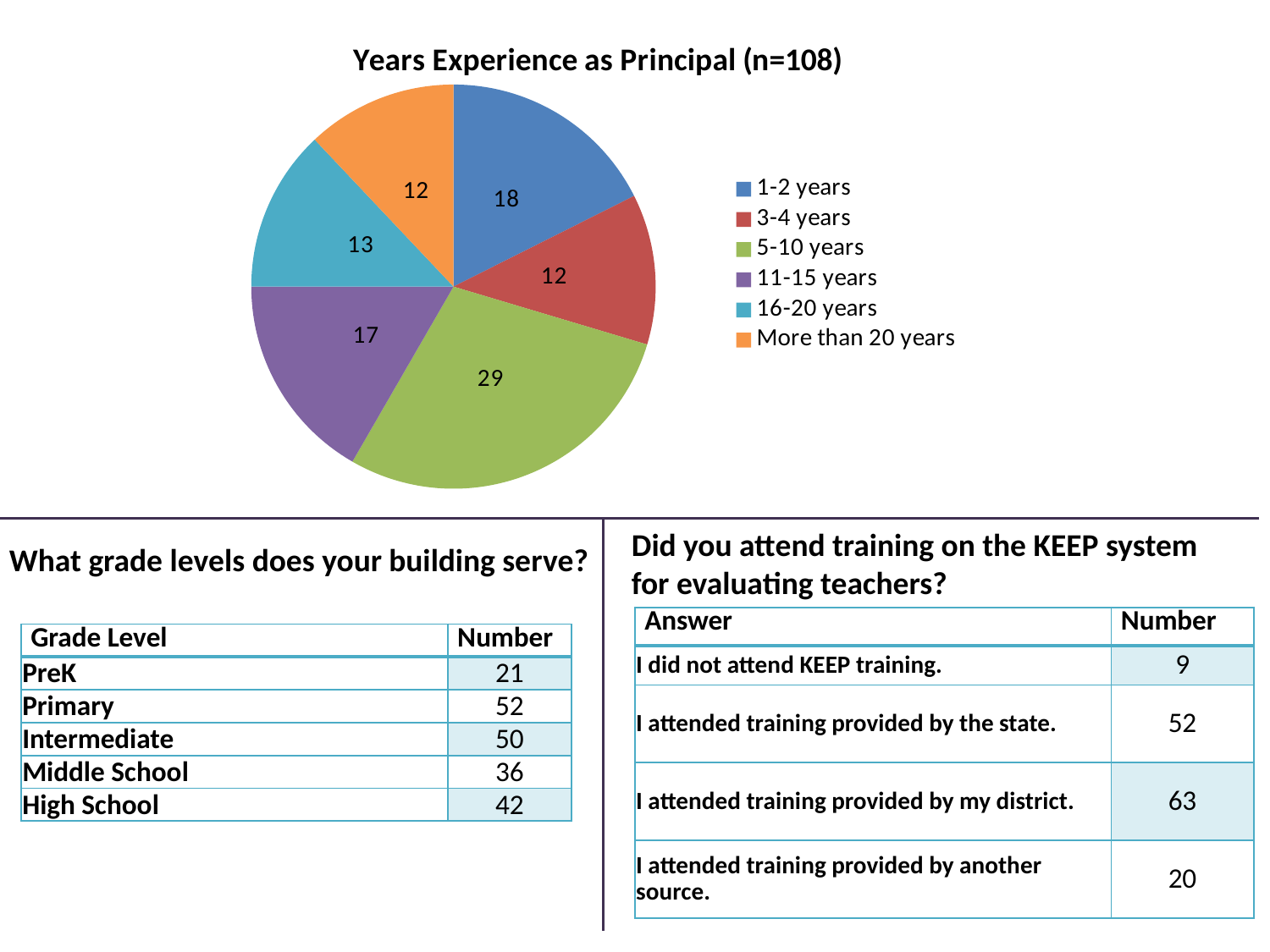
In the pie chart, what is the value for 11-15 years? 17 What type of chart is used to show years of experience as principal? Pie chart Which experience category has the largest slice in the pie chart? 5-10 years In the pie chart, how much larger is the 5-10 years value than the 1-2 years value? 11 In the pie chart, what is the value for the 1-2 years slice? 18 How many experience categories does the pie chart show? 6 In the pie chart, what is the value for 3-4 years? 12 In the pie chart, what is the difference between the 11-15 years and 16-20 years values? 4 In the pie chart, which is larger: 1-2 years or 11-15 years? 1-2 years In the pie chart, what is the value for 16-20 years? 13 What is the title of the pie chart? Years Experience as Principal (n=108) In the pie chart, how many principals have 5-10 years of experience? 29